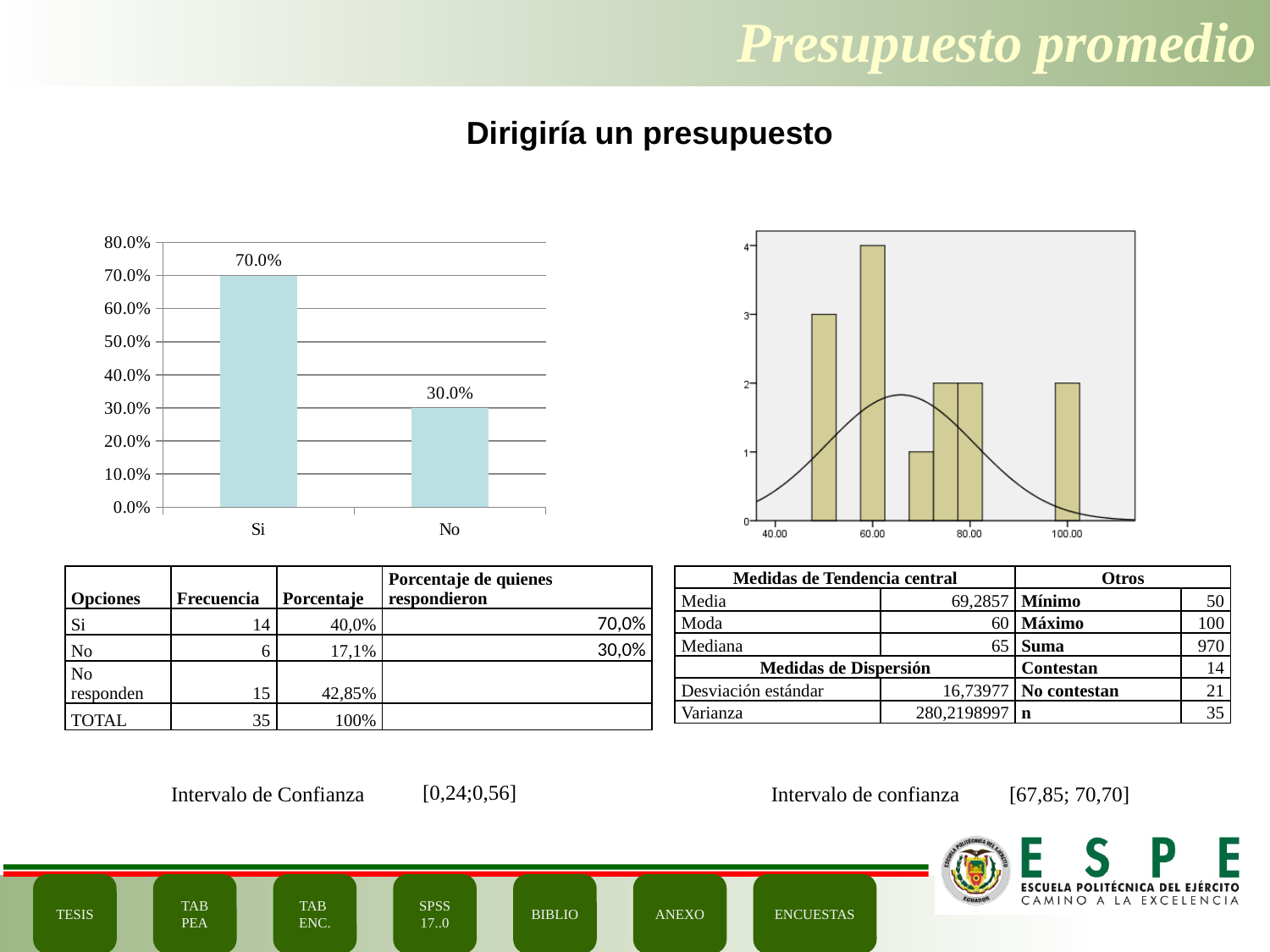
In the bar chart on the left, which category has the highest value? Si In the histogram on the right, how many bars are plotted? 6 In the bar chart on the left, how many categories are shown on the x axis? 2 In the bar chart on the left, what is the value for No? 30.0% What kind of chart is the chart on the left? bar chart In the bar chart on the left, what is the difference between the values for Si and No? 40.0% In the histogram on the right, is the height of the bar near 50.00 greater or less than 2? greater In the bar chart on the left, which is larger, the value for Si or the value for No? Si In the bar chart on the left, what is the value for Si? 70.0% In the bar chart on the left, what is the highest value shown on the y axis? 80.0% In the bar chart on the left, which category has the lowest value? No In the histogram on the right, what is the height of the tallest bar? 4